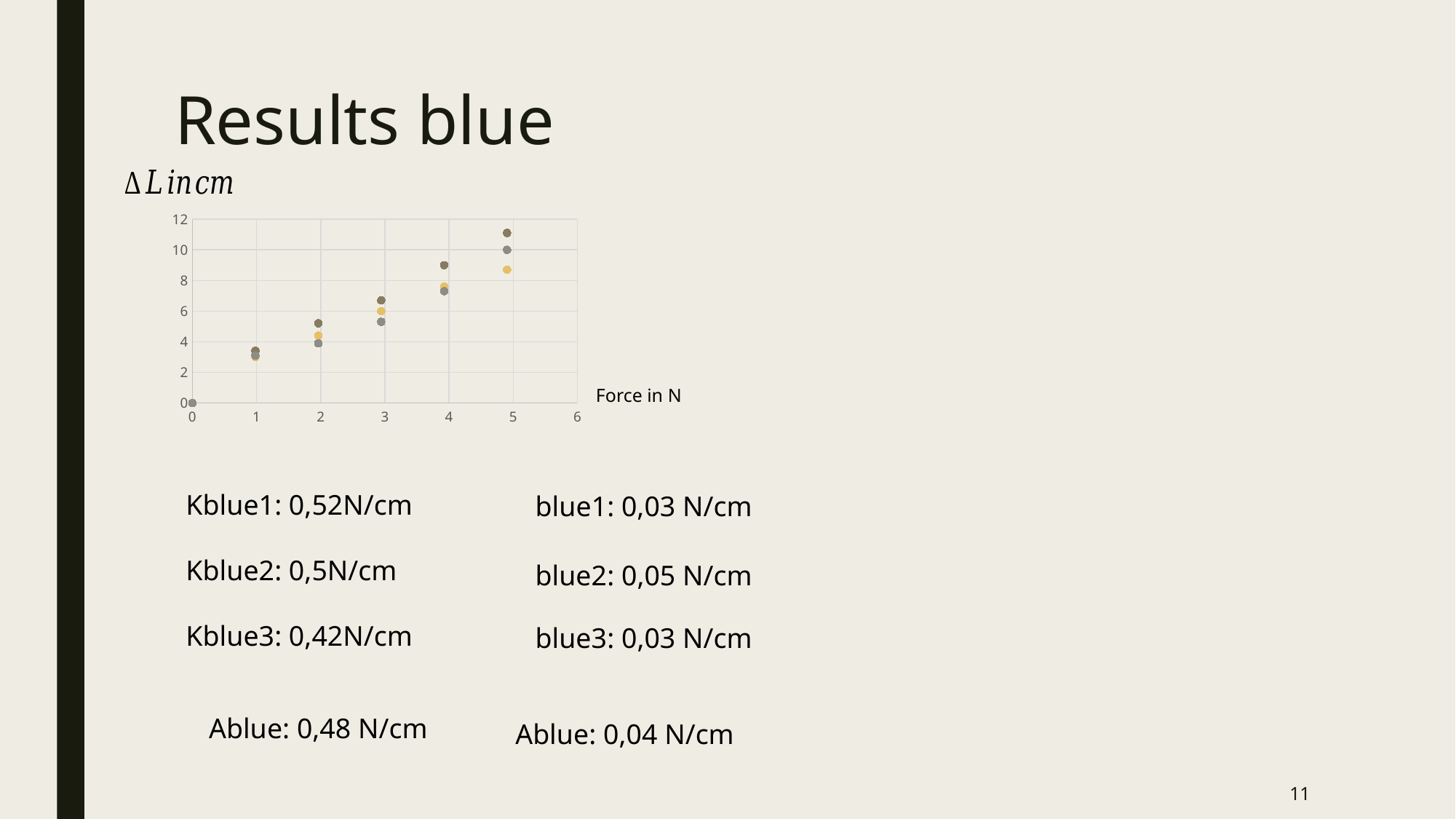
Are the plotted values at a force of 3 N greater or less than 4? greater Are the plotted values at a force of 4 N greater or less than 6? greater What is the plotted value at a force of 0 N? 0 What is the label of the horizontal axis of the chart? Force in N What is the highest value shown on the vertical axis of the chart? 12 Are the plotted values at a force of 1 N greater or less than 4? less Do the plotted values rise or fall as the force increases along the x axis? rise What kind of chart is shown on the slide? scatter chart At which force value are the plotted points lowest? 0